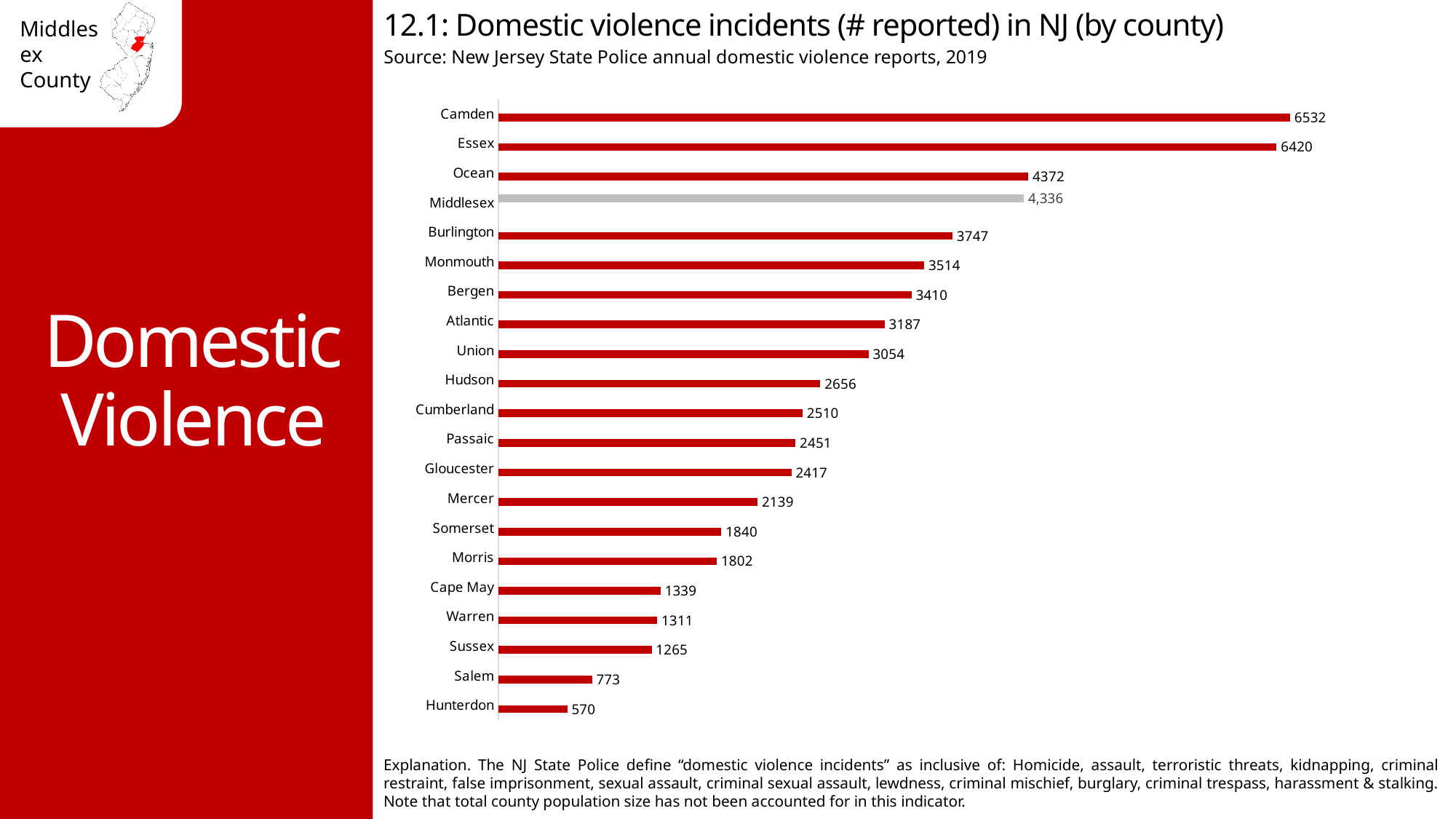
What is the number of reported domestic violence incidents for Middlesex County? 4,336 Which county has more reported incidents, Salem or Sussex? Sussex What type of chart is used on this slide? Bar chart Which county has more reported incidents, Burlington or Monmouth? Burlington What is the number of reported domestic violence incidents for Hunterdon County? 570 What is the number of reported domestic violence incidents for Camden County? 6532 What is the difference in reported incidents between Camden and Essex? 112 What is the difference in reported incidents between Ocean and Middlesex? 36 Which county has the highest number of reported domestic violence incidents? Camden How many counties are shown in the chart? 21 Which county's bar is shown in gray rather than red? Middlesex Which county has the lowest number of reported domestic violence incidents? Hunterdon